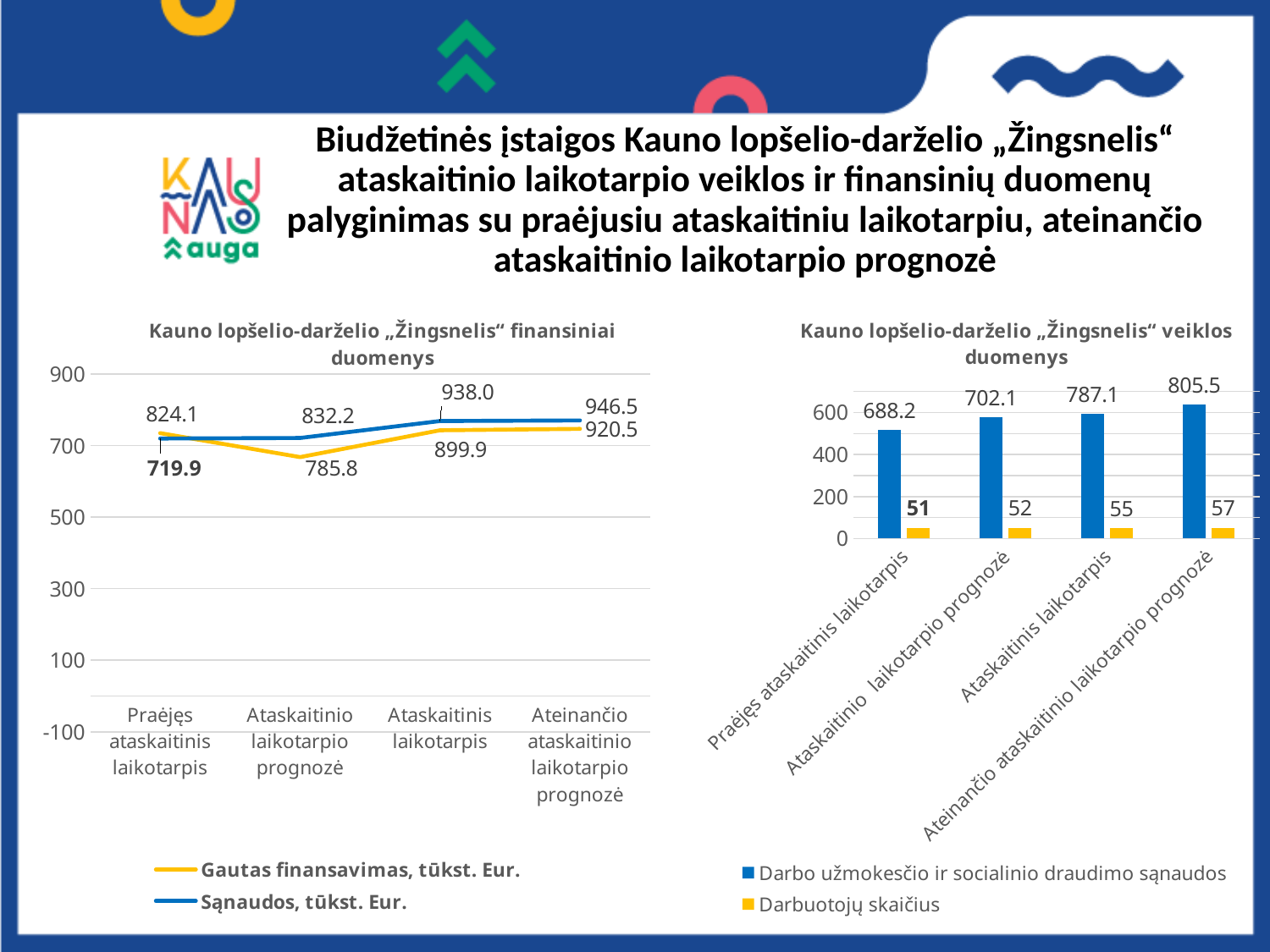
In the right chart (veiklos duomenys), which category has the highest value for Darbo užmokesčio ir socialinio draudimo sąnaudos? Ateinančio ataskaitinio laikotarpio prognozė In the right chart (veiklos duomenys), what is the difference in Darbo užmokesčio ir socialinio draudimo sąnaudos between Ateinančio ataskaitinio laikotarpio prognozė and Praėjęs ataskaitinis laikotarpis? 117.3 In the left chart (finansiniai duomenys), what is the value of Sąnaudos, tūkst. Eur. for Ateinančio ataskaitinio laikotarpio prognozė? 946.5 In the right chart (veiklos duomenys), what is the difference in Darbuotojų skaičius between Ateinančio ataskaitinio laikotarpio prognozė and Praėjęs ataskaitinis laikotarpis? 6 In the right chart (veiklos duomenys), does Darbuotojų skaičius rise or fall across the categories from left to right? rise What type of chart is the chart titled "Kauno lopšelio-darželio „Žingsnelis“ veiklos duomenys" on the right? bar chart In the right chart (veiklos duomenys), what is the value of Darbuotojų skaičius for Ateinančio ataskaitinio laikotarpio prognozė? 57 What type of chart is the chart titled "Kauno lopšelio-darželio „Žingsnelis“ finansiniai duomenys" on the left? line chart In the right chart (veiklos duomenys), what is the value of Darbo užmokesčio ir socialinio draudimo sąnaudos for Ataskaitinis laikotarpis? 787.1 How many series does the legend of the right chart (veiklos duomenys) list? 2 How many categories are shown on the x axis of the left chart (finansiniai duomenys)? 4 In the left chart (finansiniai duomenys), what is the value of Gautas finansavimas, tūkst. Eur. for Ataskaitinis laikotarpis? 899.9